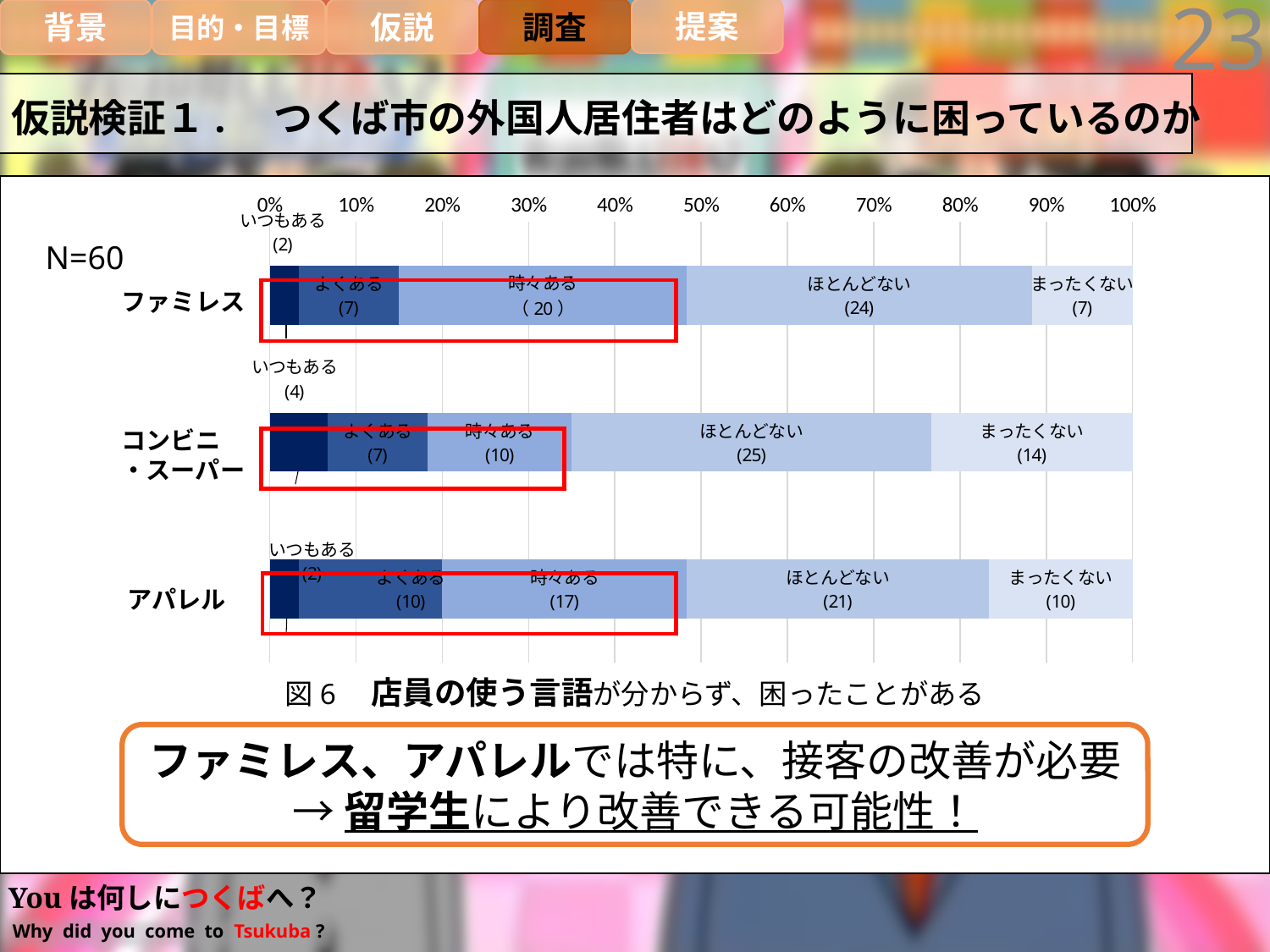
Which store type has the highest count for まったくない? コンビニ・スーパー Which store type has the lowest count for 時々ある? コンビニ・スーパー What is the count for 時々ある in the ファミレス bar? (20) What is the total count across all segments of the ファミレス bar? 60 Which is larger: the ほとんどない count for ファミレス or for アパレル? ファミレス What is the count for よくある in the アパレル bar? (10) How many categories (store types) are plotted in the chart? 3 What is the sample size (N) shown next to the chart? N=60 What kind of chart is shown on the slide? Stacked bar chart What is the count for いつもある in the コンビニ・スーパー bar? (4) What is the difference between the 時々ある counts for ファミレス and アパレル? 3 What is the count for ほとんどない in the コンビニ・スーパー bar? (25)